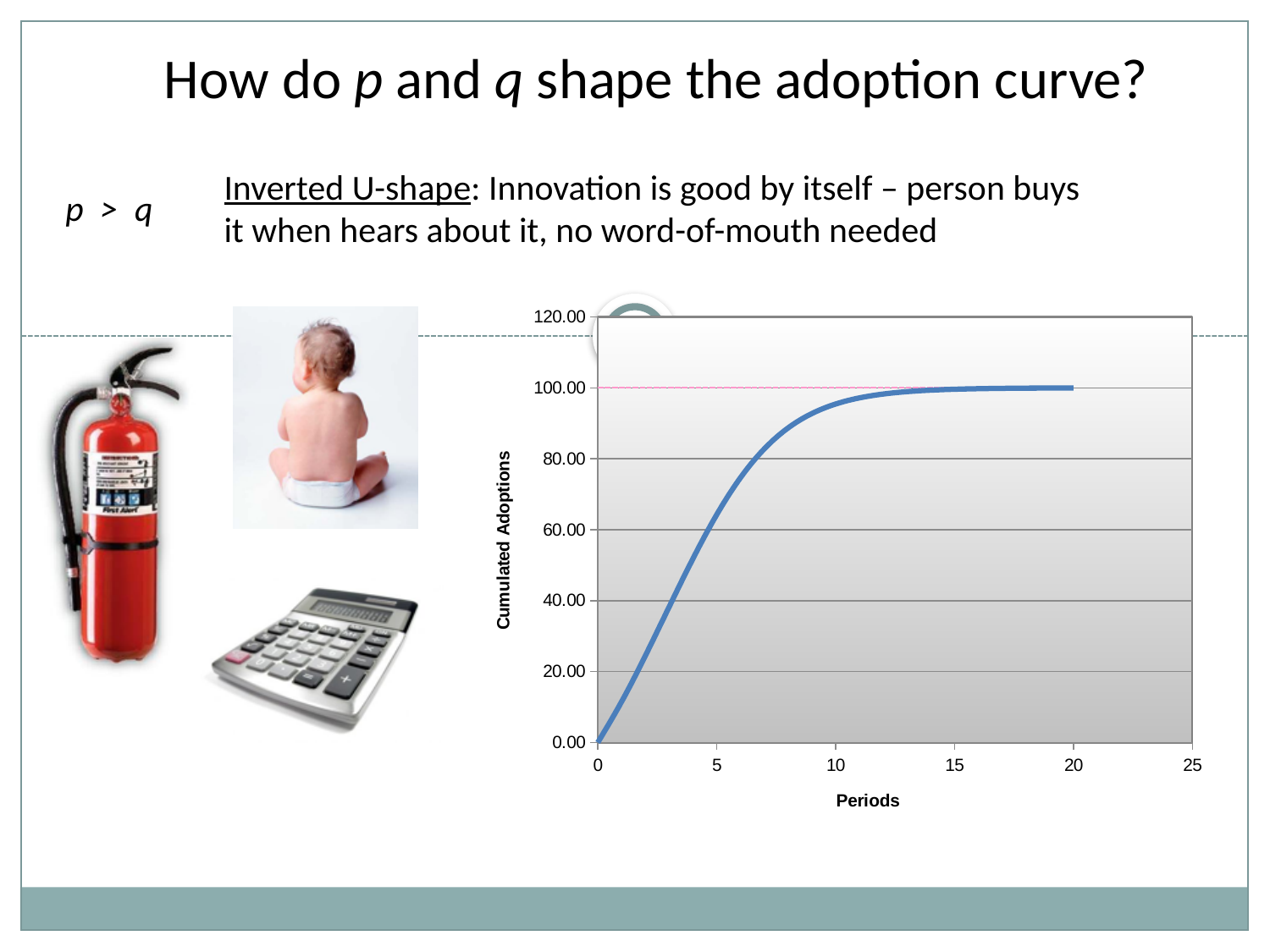
What is the title of the x axis of the chart? Periods Is the value of cumulated adoptions at period 5 greater or less than 80? less Is the value of cumulated adoptions at period 5 greater or less than 40? greater What is the highest value shown on the y axis of the chart? 120.00 What is the title of the y axis of the chart? Cumulated Adoptions What kind of chart is shown on the slide? line chart Is the value of cumulated adoptions at period 20 greater or less than 120? less Which has the larger cumulated adoptions value, period 5 or period 15? period 15 What is the value of cumulated adoptions at period 0? 0.00 Do cumulated adoptions rise or fall as the number of periods increases? rise